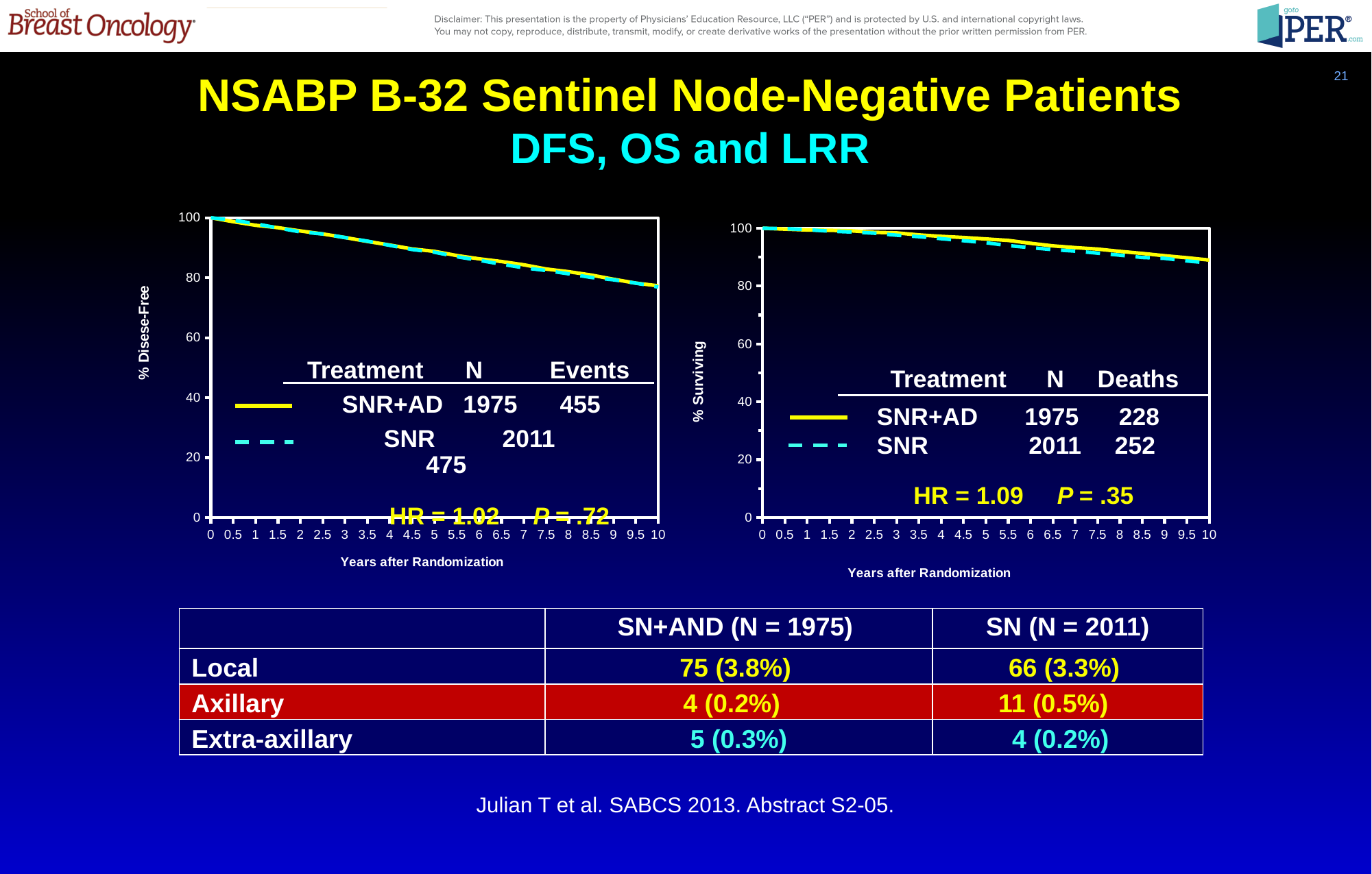
What hazard ratio (HR) is shown on the right chart (% Surviving)? 1.09 What kind of chart is the left chart (% Disease-Free)? line chart In the left chart (% Disease-Free), do the values rise or fall as years after randomization increase? fall In the left chart (% Disease-Free), is the value for SNR+AD at 10 years greater or less than 80? less In the right chart (% Surviving), which treatment has more deaths, SNR+AD or SNR? SNR In the right chart (% Surviving), do the values rise or fall as years after randomization increase? fall In the left chart (% Disease-Free), how many events are listed for SNR+AD? 455 What is the x-axis label of the right chart (% Surviving)? Years after Randomization In the right chart (% Surviving), what is the difference in deaths between SNR and SNR+AD? 24 How many series does the legend of the left chart (% Disease-Free) list? 2 In the right chart (% Surviving), how many deaths are listed for SNR? 252 In the right chart (% Surviving), is the value for SNR+AD at 10 years greater or less than 80? greater